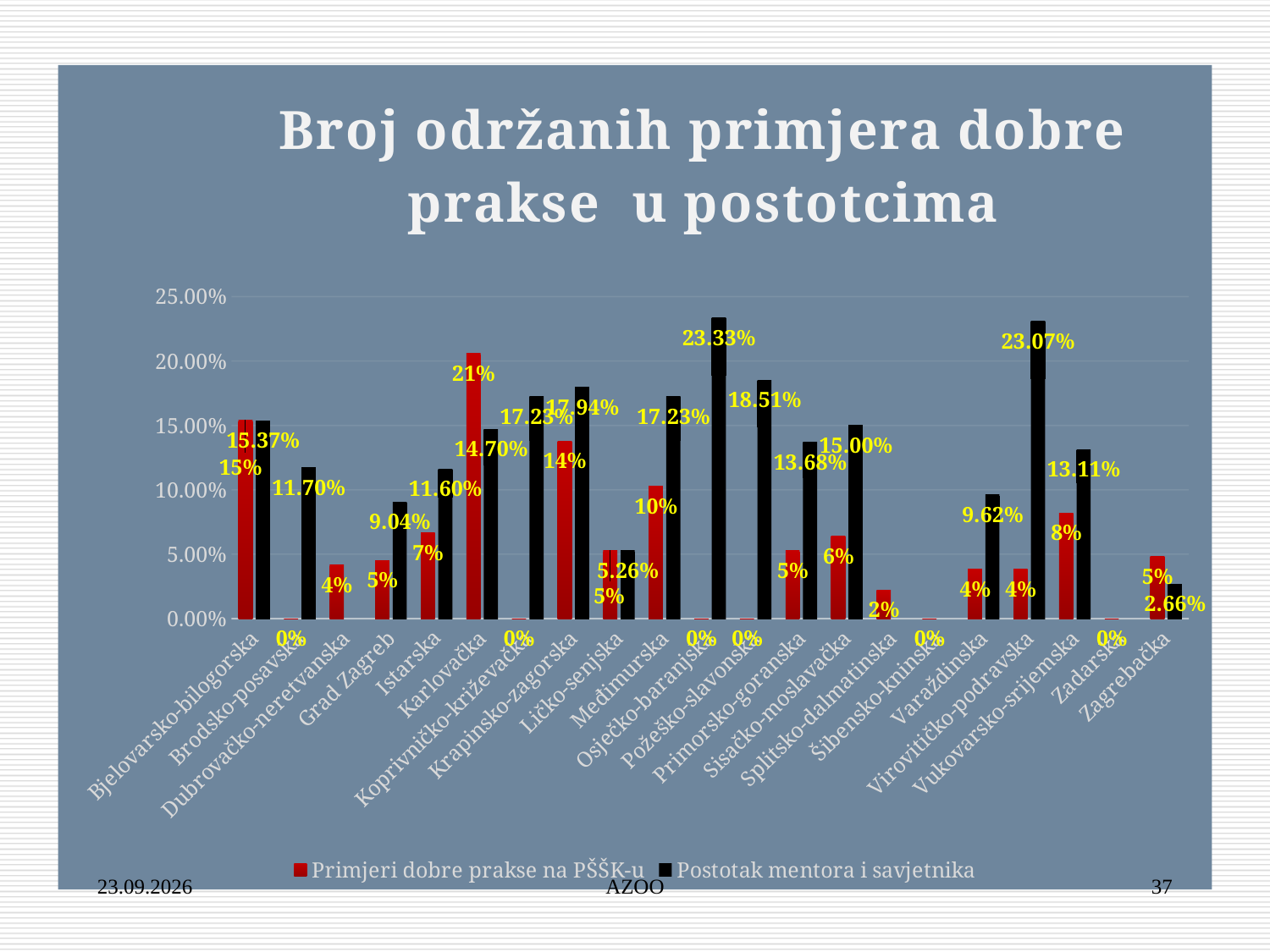
What is the value of 'Postotak mentora i savjetnika' for Zagrebačka? 2.66% How many series does the legend list? 2 Which county has the highest value for 'Primjeri dobre prakse na PŠŠK-u'? Karlovačka What kind of chart is shown on the slide? bar chart What is the value of 'Primjeri dobre prakse na PŠŠK-u' for Karlovačka? 21% Is the value of 'Postotak mentora i savjetnika' for Virovitičko-podravska greater or less than 20.00%? greater What is the value of 'Postotak mentora i savjetnika' for Osječko-baranjska? 23.33% Which county has the highest value for 'Postotak mentora i savjetnika'? Osječko-baranjska How many counties (categories) are shown on the x axis? 21 What is the value of 'Postotak mentora i savjetnika' for Vukovarsko-srijemska? 13.11% For Karlovačka, which is larger: 'Primjeri dobre prakse na PŠŠK-u' or 'Postotak mentora i savjetnika'? Primjeri dobre prakse na PŠŠK-u